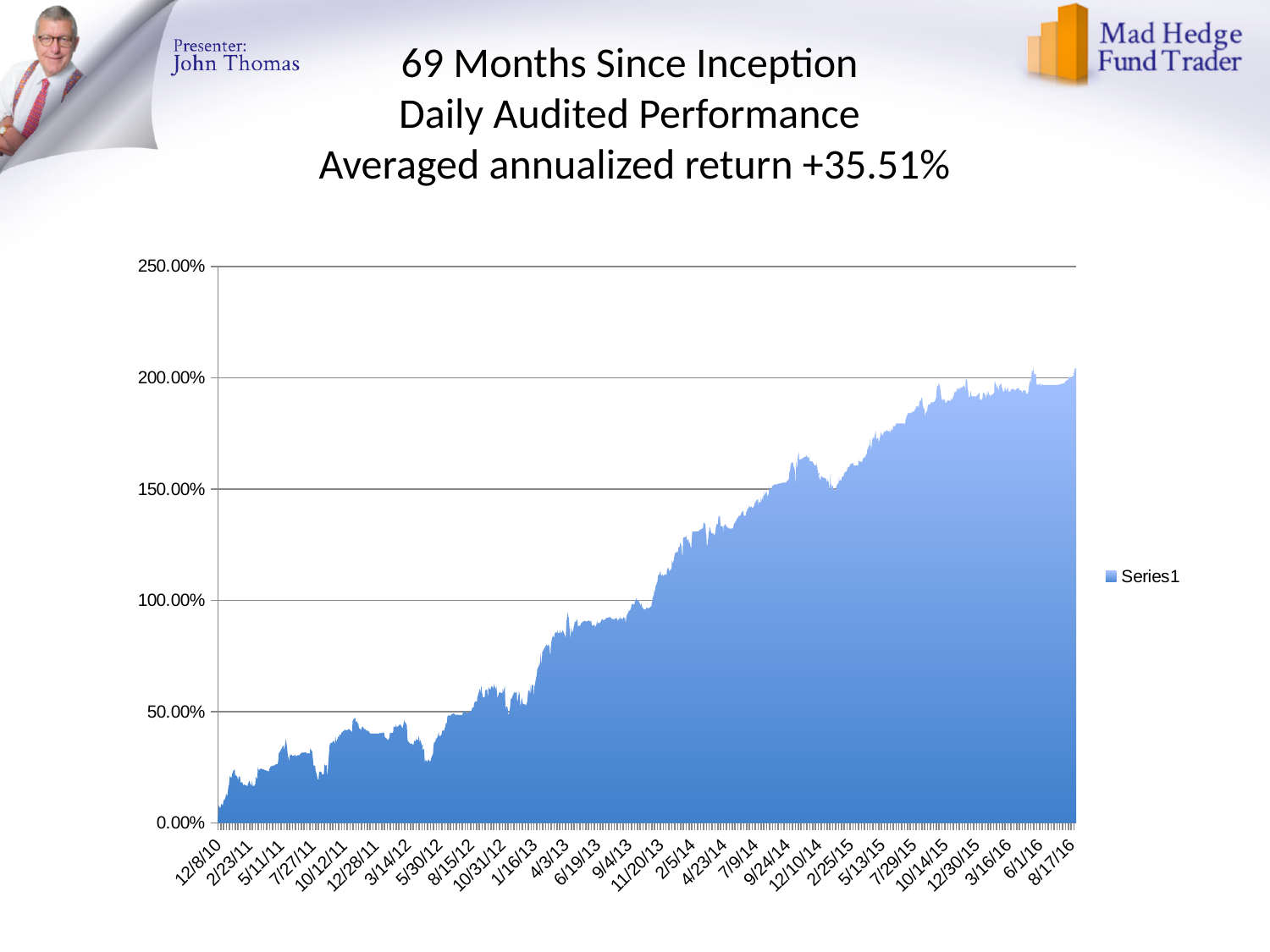
Is the value at 7/9/14 greater or less than 100.00%? greater Is the value at 10/14/15 greater or less than 150.00%? greater What kind of chart is shown on the slide? area chart How many series does the legend list? 1 Is the value at 1/16/13 greater or less than 100.00%? less Overall, do the values rise or fall from 12/8/10 to 8/17/16? rise What is the first date label on the x axis? 12/8/10 What is the name of the series shown in the legend? Series1 What is the highest value shown on the y axis? 250.00%